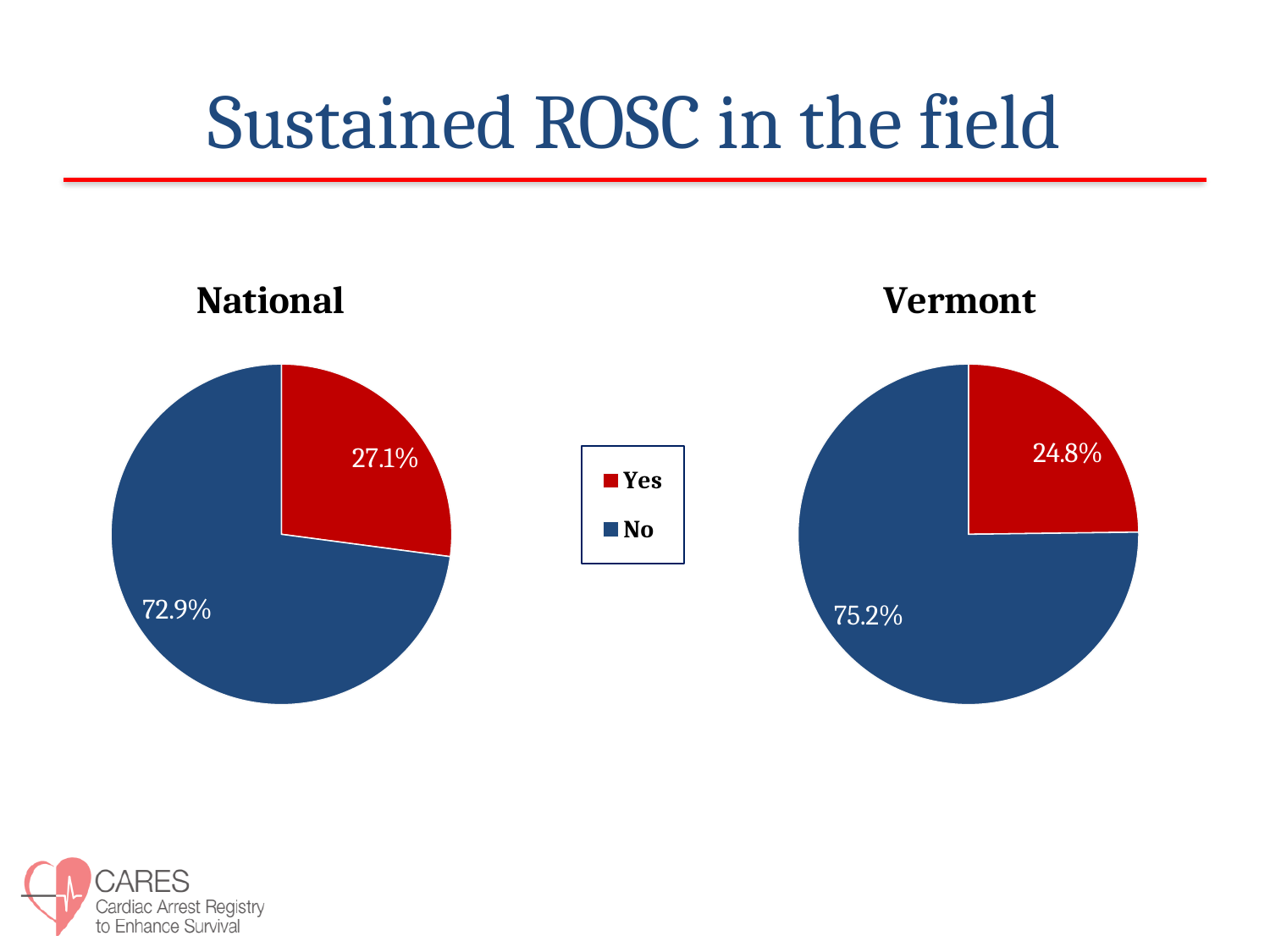
What colour represents Yes in the pie charts? Red How many categories does the legend list? 2 In the National pie chart, what percentage is shown for No? 72.9% What type of chart is used on this slide? Pie chart What is the difference between the Yes percentage in the National pie chart and the Yes percentage in the Vermont pie chart? 2.3% In the Vermont pie chart, what percentage is shown for No? 75.2% Is the Yes share larger in the National pie chart or the Vermont pie chart? National In the National pie chart, which category has the smallest slice? Yes In the Vermont pie chart, what percentage is shown for Yes? 24.8% In the National pie chart, what is the difference between the No and Yes percentages? 45.8% In the National pie chart, what percentage is shown for Yes? 27.1% In the Vermont pie chart, which category has the largest slice? No